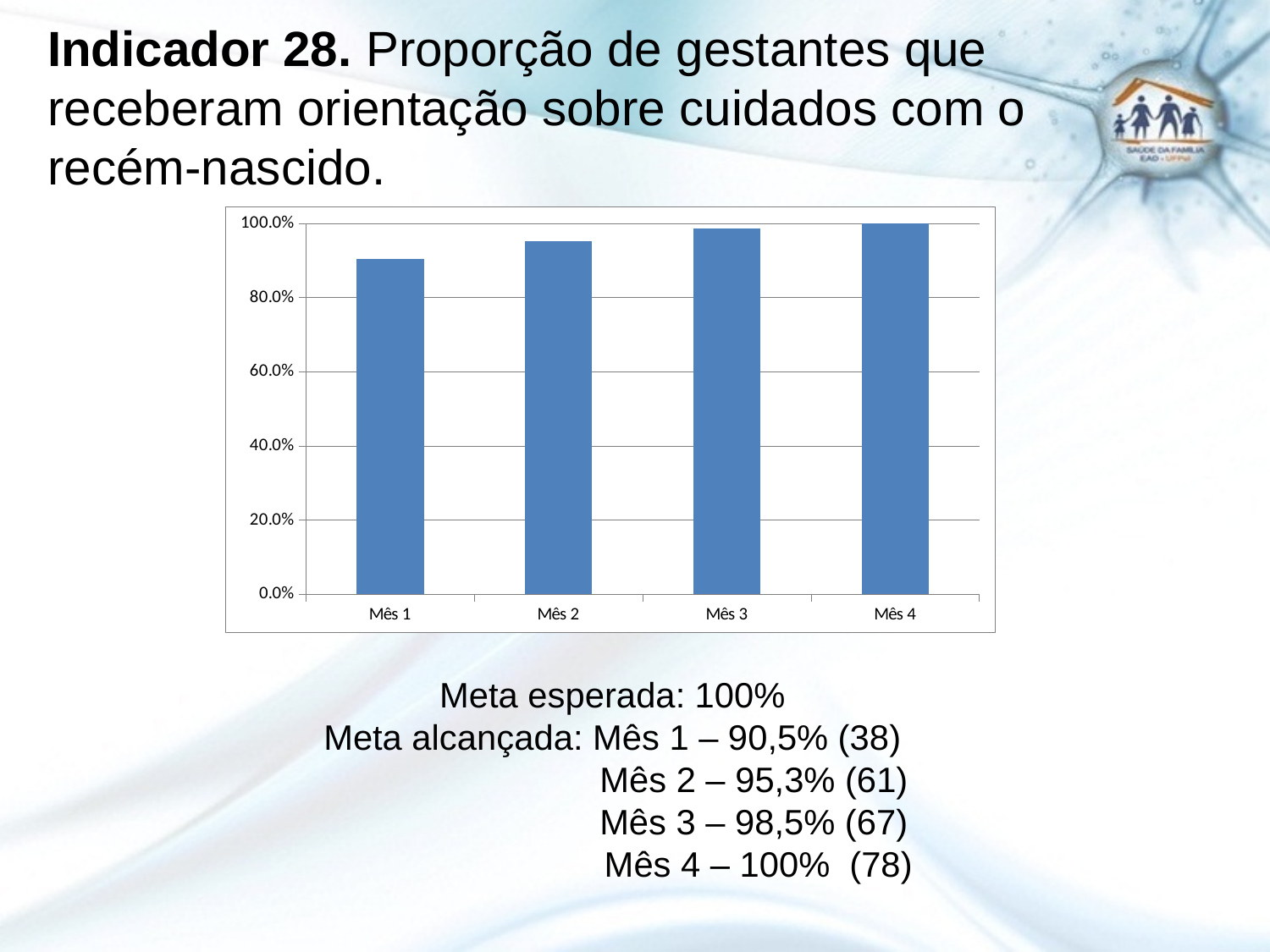
Is the value for Mês 2 greater or less than 100.0%? less What is the expected target (meta esperada) stated on the slide? 100% What type of chart is shown on the slide? bar chart Do the values rise or fall from Mês 1 to Mês 4? rise According to the slide, what proportion was achieved in Mês 1? 90,5% Which month has the highest value on the chart? Mês 4 Which is larger, the value for Mês 1 or the value for Mês 4? Mês 4 What value does the bar for Mês 4 reach on the chart? 100.0% According to the slide, what proportion was achieved in Mês 3? 98,5% How many categories (months) are plotted on the chart? 4 Which month has the lowest value on the chart? Mês 1 Is the value for Mês 1 greater or less than 80.0%? greater